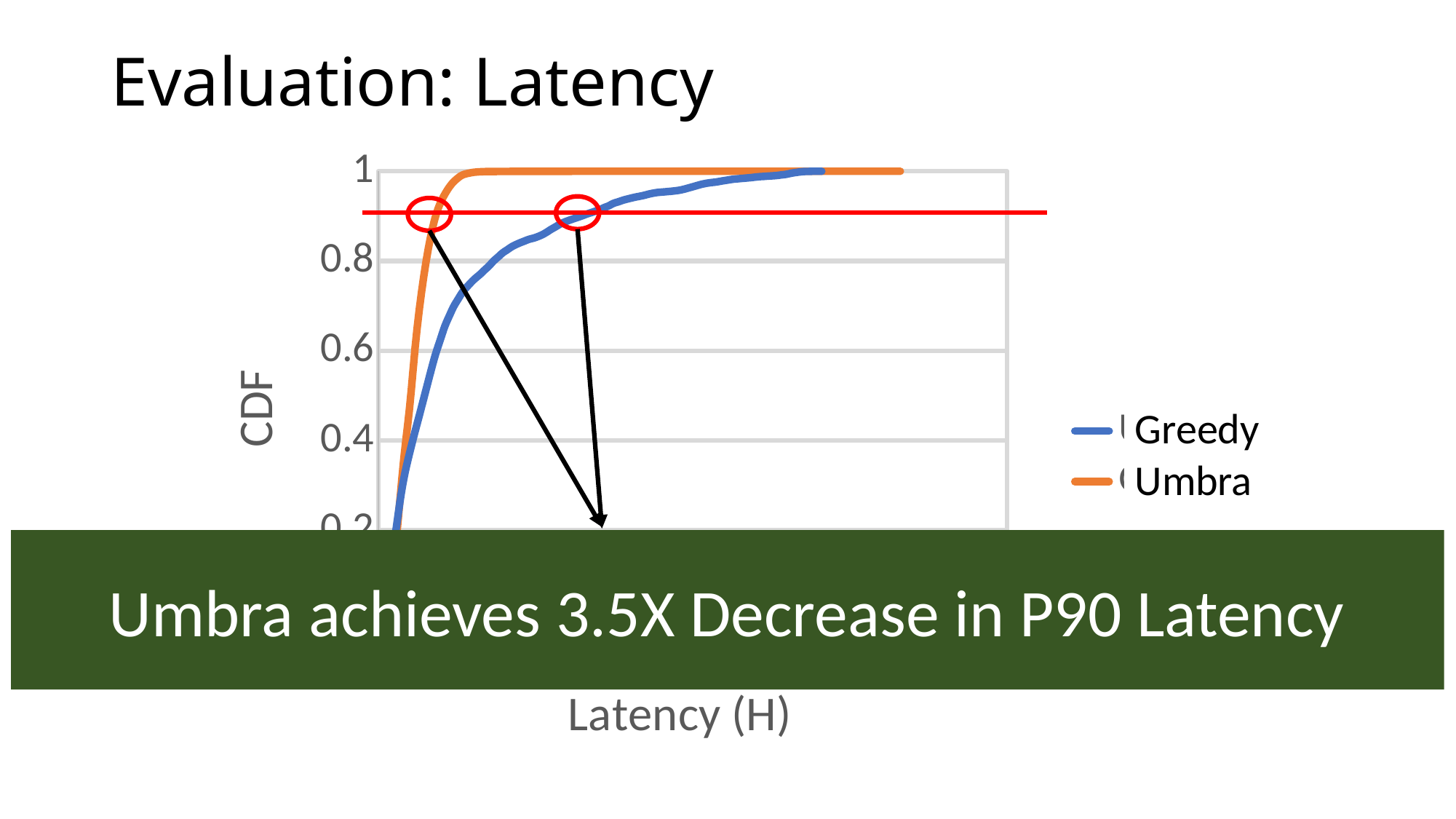
What is the label of the y axis? CDF Which series reaches a CDF of 1 at a lower latency, Greedy or Umbra? Umbra What is the lowest y-axis tick value visible on the chart? 0.2 Do the CDF curves rise or fall as latency increases along the x axis? rise According to the slide, by what factor does Umbra decrease P90 latency compared to Greedy? 3.5X Which series crosses the red horizontal line at CDF 0.9 at a lower latency? Umbra Which series has the higher CDF value at the latency where Umbra first reaches 1? Umbra How many series does the legend list? 2 What are the two series named in the legend? Greedy and Umbra What kind of chart is shown on the slide? line chart What is the highest value shown on the y axis? 1